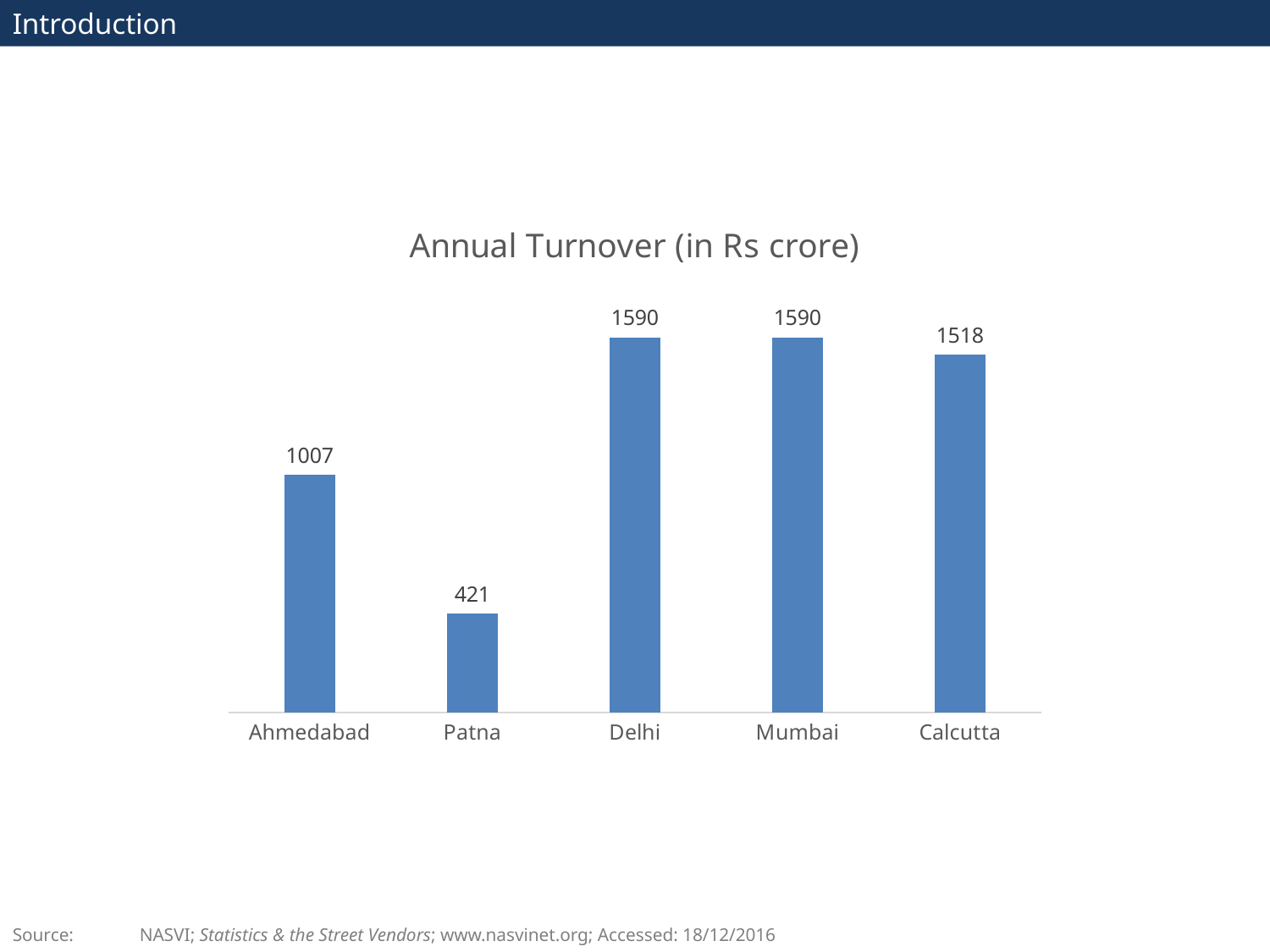
What is the annual turnover for Ahmedabad? 1007 What is the annual turnover for Patna? 421 Which has a larger annual turnover, Patna or Ahmedabad? Ahmedabad What is the annual turnover for Calcutta? 1518 What is the difference in annual turnover between Delhi and Patna? 1169 What is the title of the chart? Annual Turnover (in Rs crore) Which city has the lowest annual turnover? Patna What is the annual turnover for Mumbai? 1590 Which has a larger annual turnover, Ahmedabad or Calcutta? Calcutta How many cities are shown in the chart? 5 What is the difference in annual turnover between Calcutta and Ahmedabad? 511 What kind of chart is shown on the slide? Bar chart